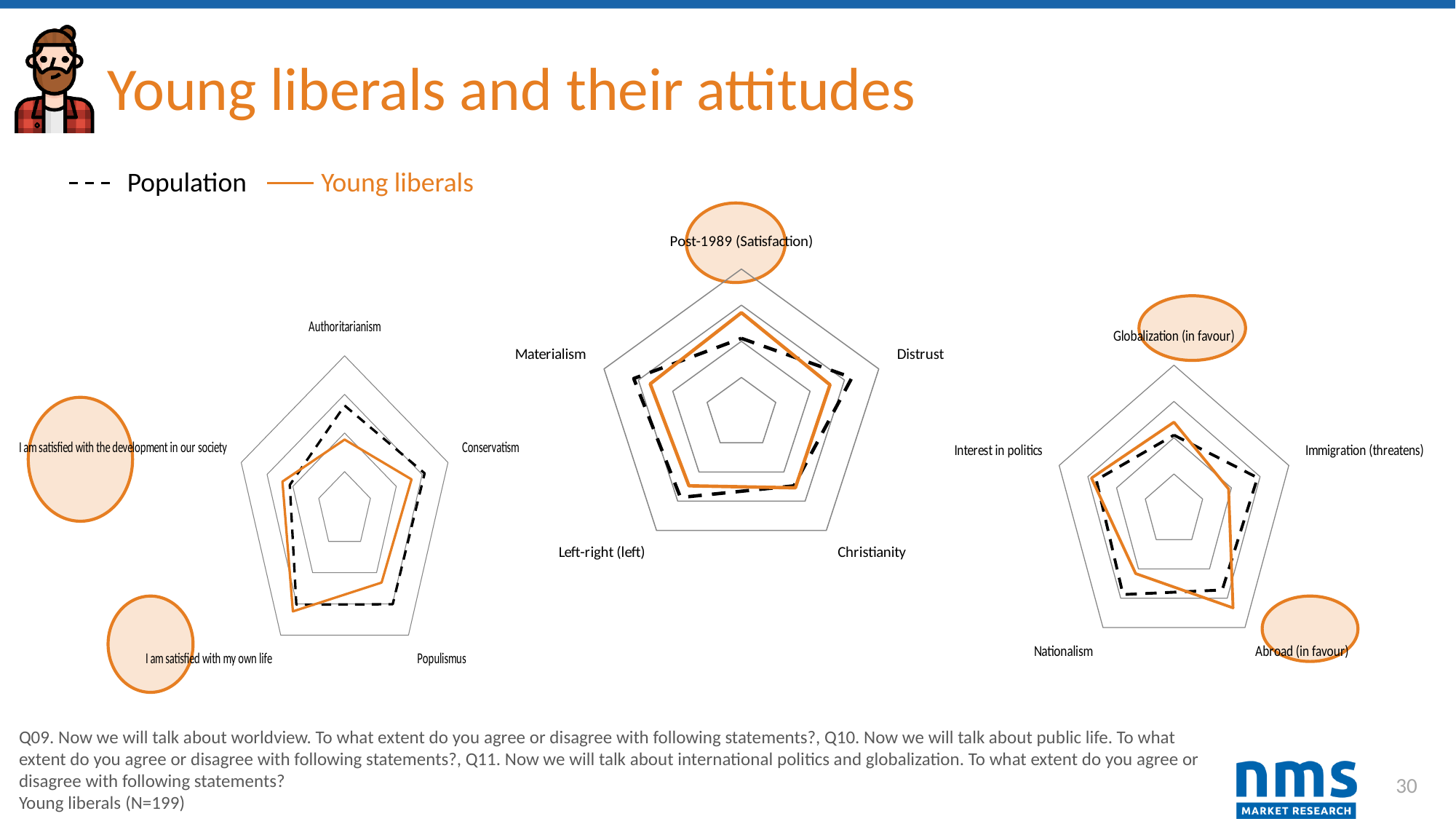
In the right chart, which series has the higher value on the Immigration (threatens) axis? Population In the right chart, which series has the higher value on the Abroad (in favour) axis? Young liberals How many axes (categories) does the right chart (with the Globalization (in favour) axis) have? 5 How many axes (categories) does the left chart (with the Authoritarianism axis) have? 5 What kind of chart is the middle chart (with the Post-1989 (Satisfaction) axis)? Radar chart In the middle chart, which series has the higher value on the Post-1989 (Satisfaction) axis? Young liberals How many series does the legend list? 2 Which series is shown with a dashed line in the legend? Population